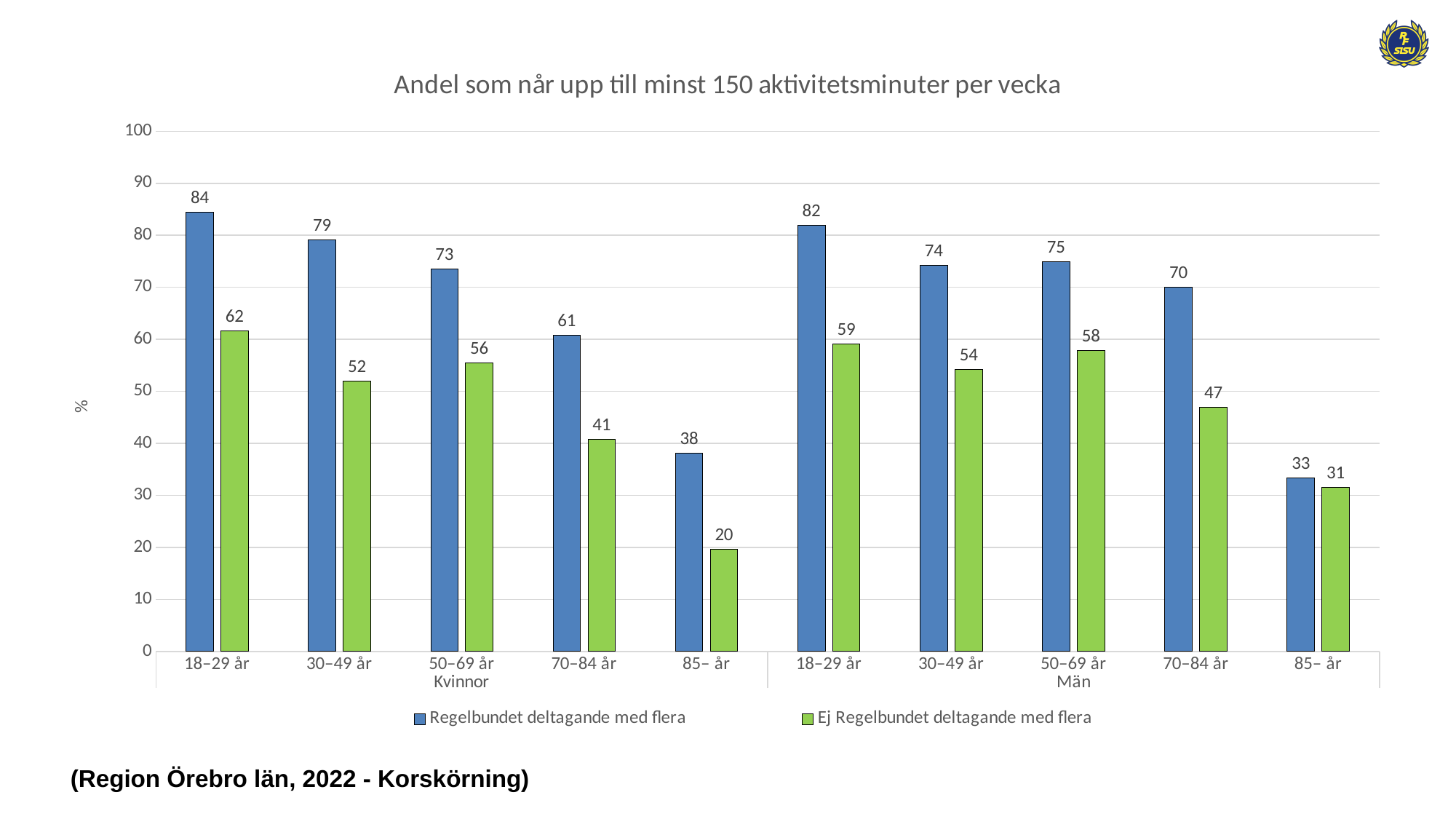
Which group has the highest value for 'Regelbundet deltagande med flera'? Kvinnor 18–29 år What is the value for 'Regelbundet deltagande med flera' for Kvinnor aged 18–29 år? 84 Is the value for 'Ej Regelbundet deltagande med flera' for Män aged 18–29 år greater or less than 50? greater Which group has the lowest value for 'Ej Regelbundet deltagande med flera'? Kvinnor 85– år What is the value for 'Ej Regelbundet deltagande med flera' for Män aged 70–84 år? 47 Which is larger: 'Regelbundet deltagande med flera' for Män 50–69 år or for Kvinnor 50–69 år? Män 50–69 år What is the value for 'Ej Regelbundet deltagande med flera' for Kvinnor aged 85– år? 20 What kind of chart is shown on the slide? Bar chart How many series does the legend list? 2 What is the title of the chart? Andel som når upp till minst 150 aktivitetsminuter per vecka What is the difference between 'Regelbundet deltagande med flera' and 'Ej Regelbundet deltagande med flera' for Kvinnor aged 30–49 år? 27 How many age groups are shown on the x axis in total across Kvinnor and Män? 10